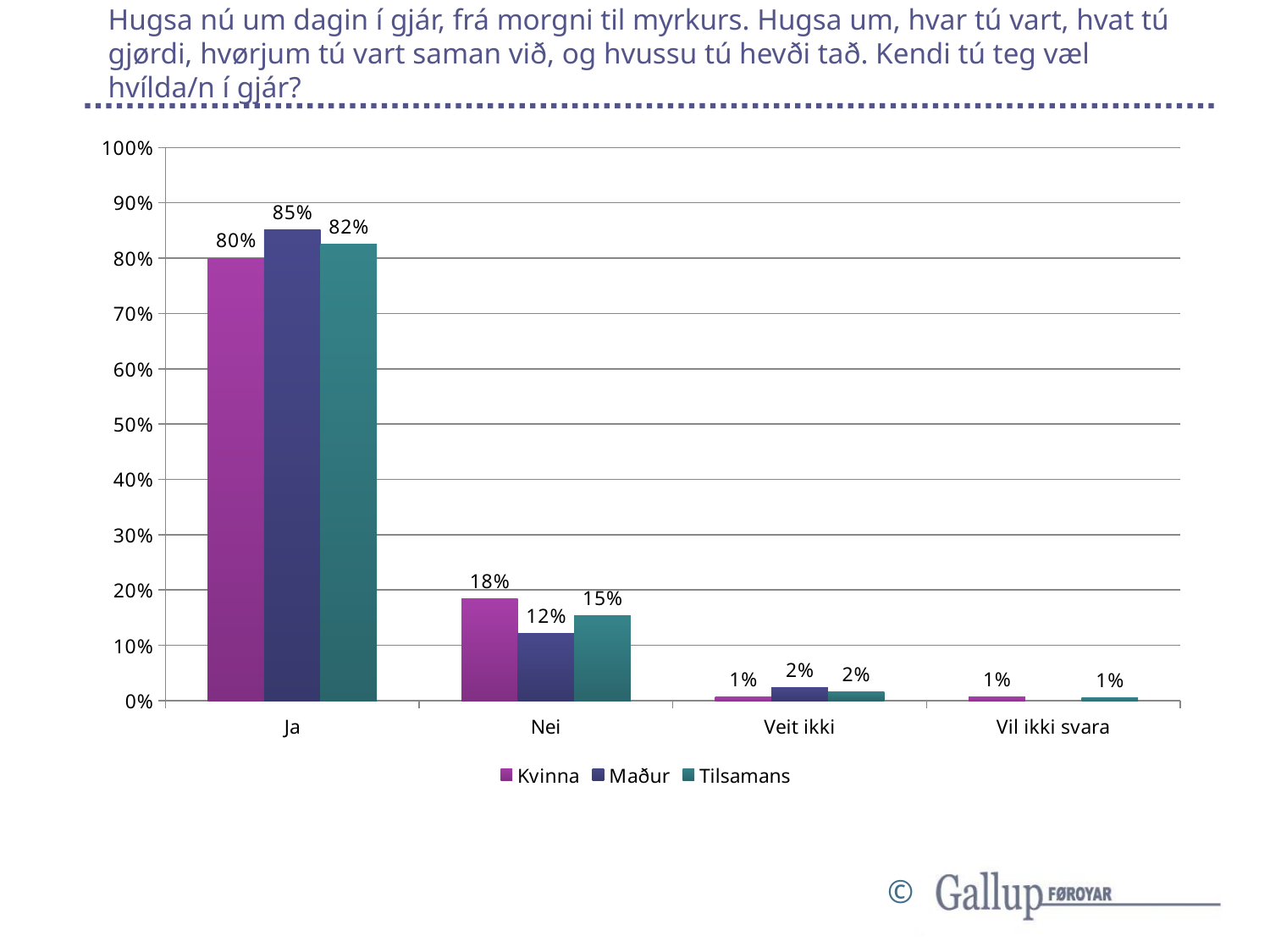
Which category has the highest value for Maður? Ja What is the value for Tilsamans in the Ja category? 82% What kind of chart is shown on the slide? bar chart What is the value for Kvinna in the Ja category? 80% What is the difference between the Maður and Kvinna values in the Ja category? 5% Is the value for Tilsamans in the Nei category greater or less than 20%? less Which series is shown in teal in the legend? Tilsamans In the Nei category, which is larger: Kvinna or Maður? Kvinna What is the value for Maður in the Nei category? 12% How many series does the legend list? 3 How many categories are shown on the x axis? 4